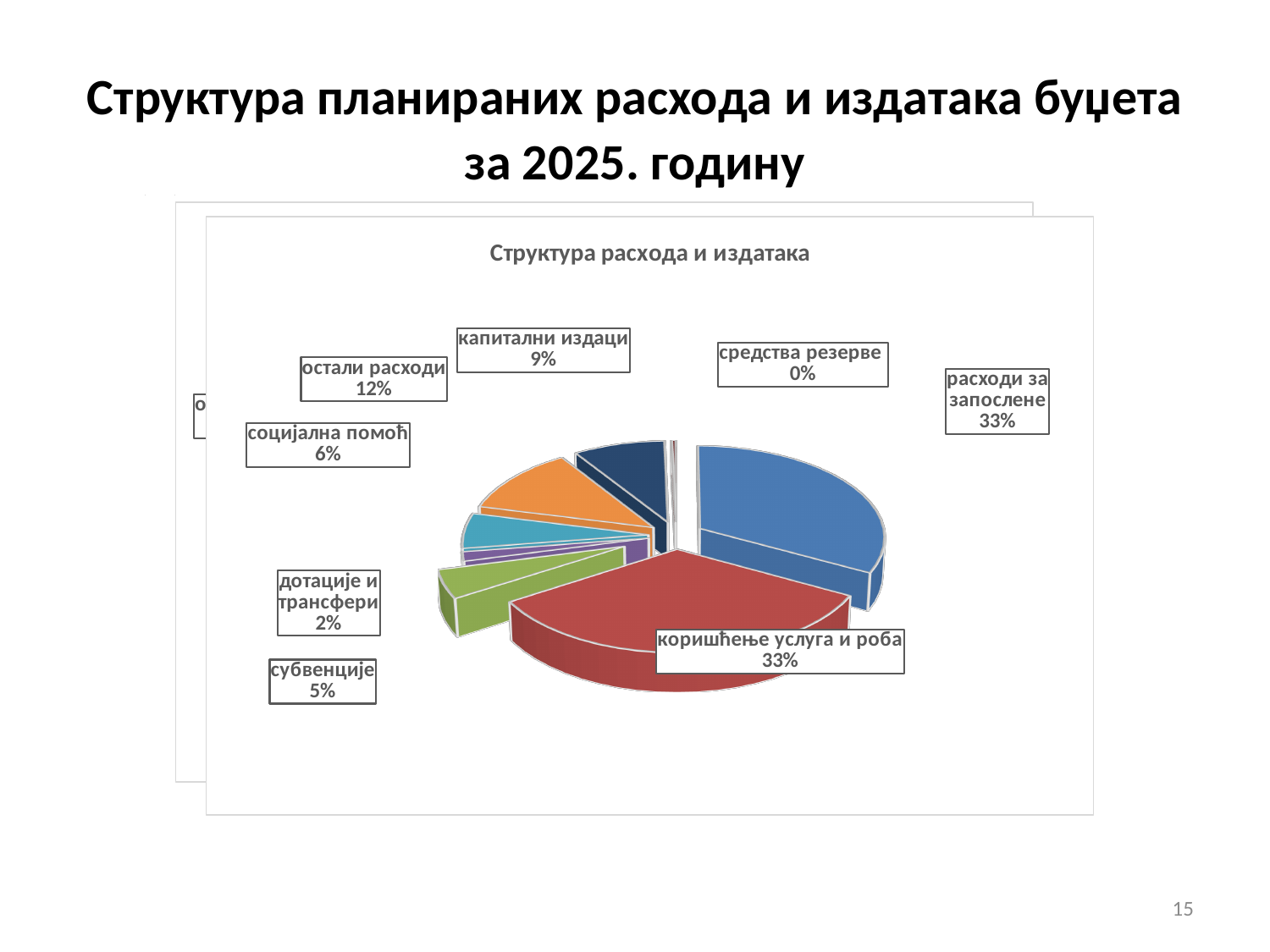
What is the title of the chart? Структура расхода и издатака What percentage is shown for коришћење услуга и роба? 33% What share of the pie does капитални издаци represent? 9% Which labelled category has the smallest share of the pie? средства резерве What share of the pie does субвенције represent? 5% What percentage is shown for расходи за запослене? 33% What is the difference in percentage points between остали расходи and капитални издаци? 3 What share of the pie does социјална помоћ represent? 6% What kind of chart is shown on the slide? pie chart Which is larger, the share for остали расходи or the share for капитални издаци? остали расходи